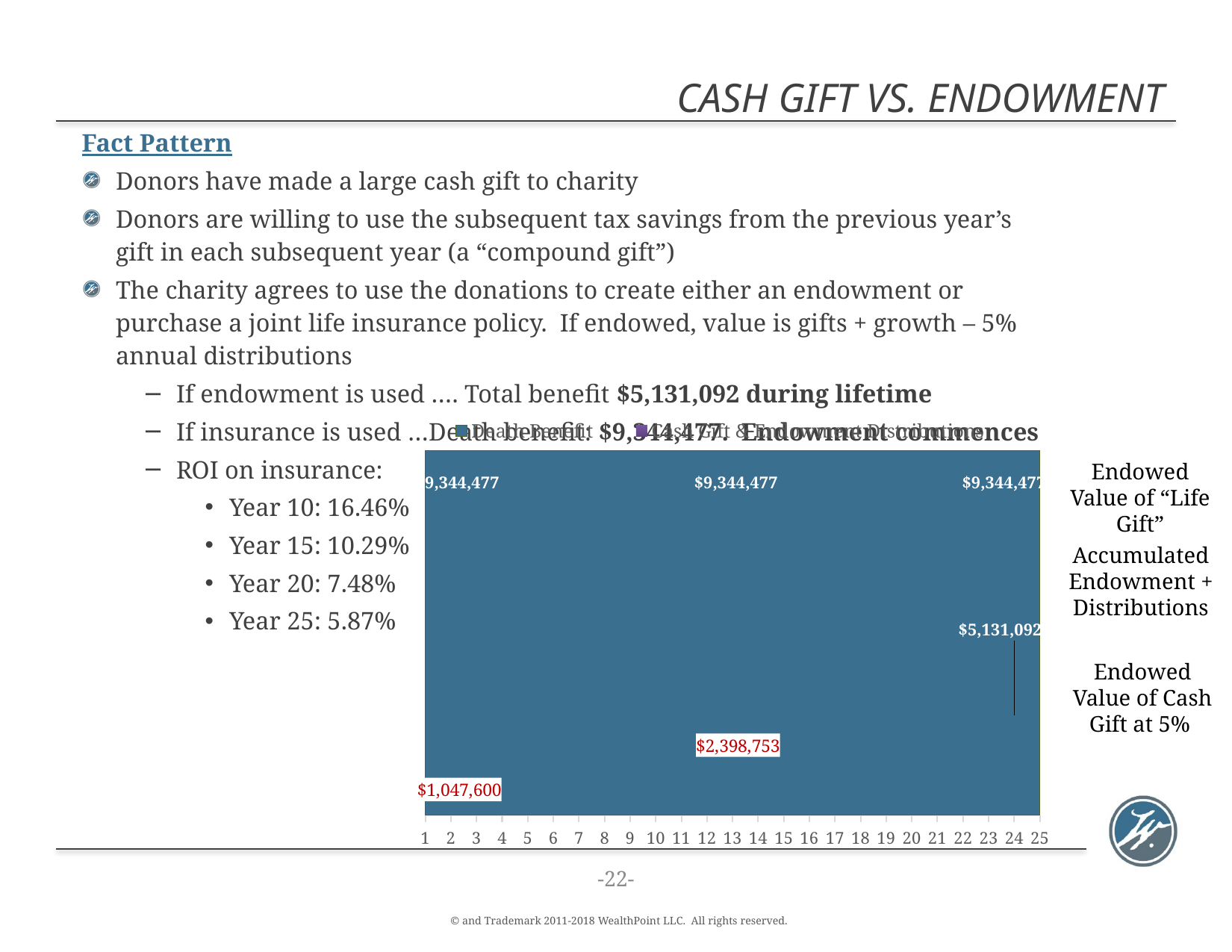
What value is printed in red at the bottom left of the chart, above year 1? $1,047,600 What is the difference between the $9,344,477 label and the $5,131,092 label on the chart? $4,213,385 How many year categories are shown on the x axis of the chart? 25 What value is printed as the data label at the top right of the chart? $9,344,477 What value is printed near year 24 on the right side of the chart, below the $9,344,477 label? $5,131,092 What is the last category label on the x axis of the chart? 25 What is the difference between the $2,398,753 label and the $1,047,600 label on the chart? $1,351,153 Which is larger on the chart: the value labeled near year 24 ($5,131,092) or the value labeled near year 12 ($2,398,753)? $5,131,092 Do the red and lower labeled values ($1,047,600, $2,398,753, $5,131,092) rise or fall from left to right along the x axis? Rise What kind of chart is shown on the slide? Area chart What is the difference between the $9,344,477 label and the $1,047,600 label on the chart? $8,296,877 What value is printed in red near the middle of the chart, around year 12? $2,398,753